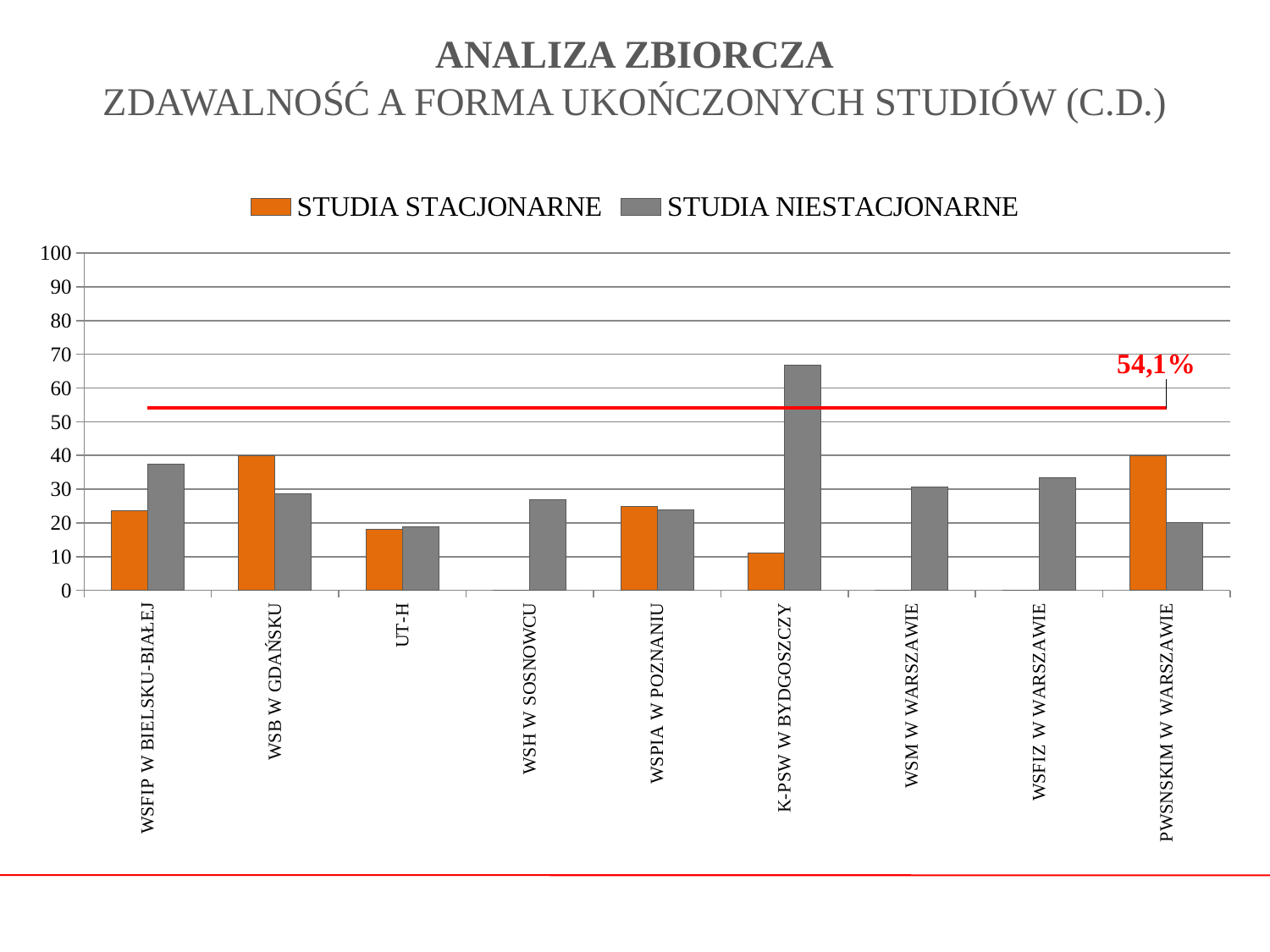
What kind of chart is shown on the slide? bar chart For WSFIP W BIELSKU-BIAŁEJ, which series has the larger value, STUDIA STACJONARNE or STUDIA NIESTACJONARNE? STUDIA NIESTACJONARNE How many series does the legend list? 2 Which institution has the highest value for STUDIA NIESTACJONARNE? K-PSW W BYDGOSZCZY How many institutions (categories) are shown on the x axis? 9 For PWSNSKIM W WARSZAWIE, which series has the larger value, STUDIA STACJONARNE or STUDIA NIESTACJONARNE? STUDIA STACJONARNE Among the institutions that have a STUDIA STACJONARNE bar, which has the lowest value? K-PSW W BYDGOSZCZY What value is labelled on the red horizontal line across the chart? 54,1% Is the STUDIA STACJONARNE value for K-PSW W BYDGOSZCZY greater or less than 20? less What colour represents STUDIA STACJONARNE in the legend? orange Is the STUDIA STACJONARNE value for WSB W GDAŃSKU greater or less than 30? greater Is the STUDIA NIESTACJONARNE value for K-PSW W BYDGOSZCZY greater or less than 60? greater